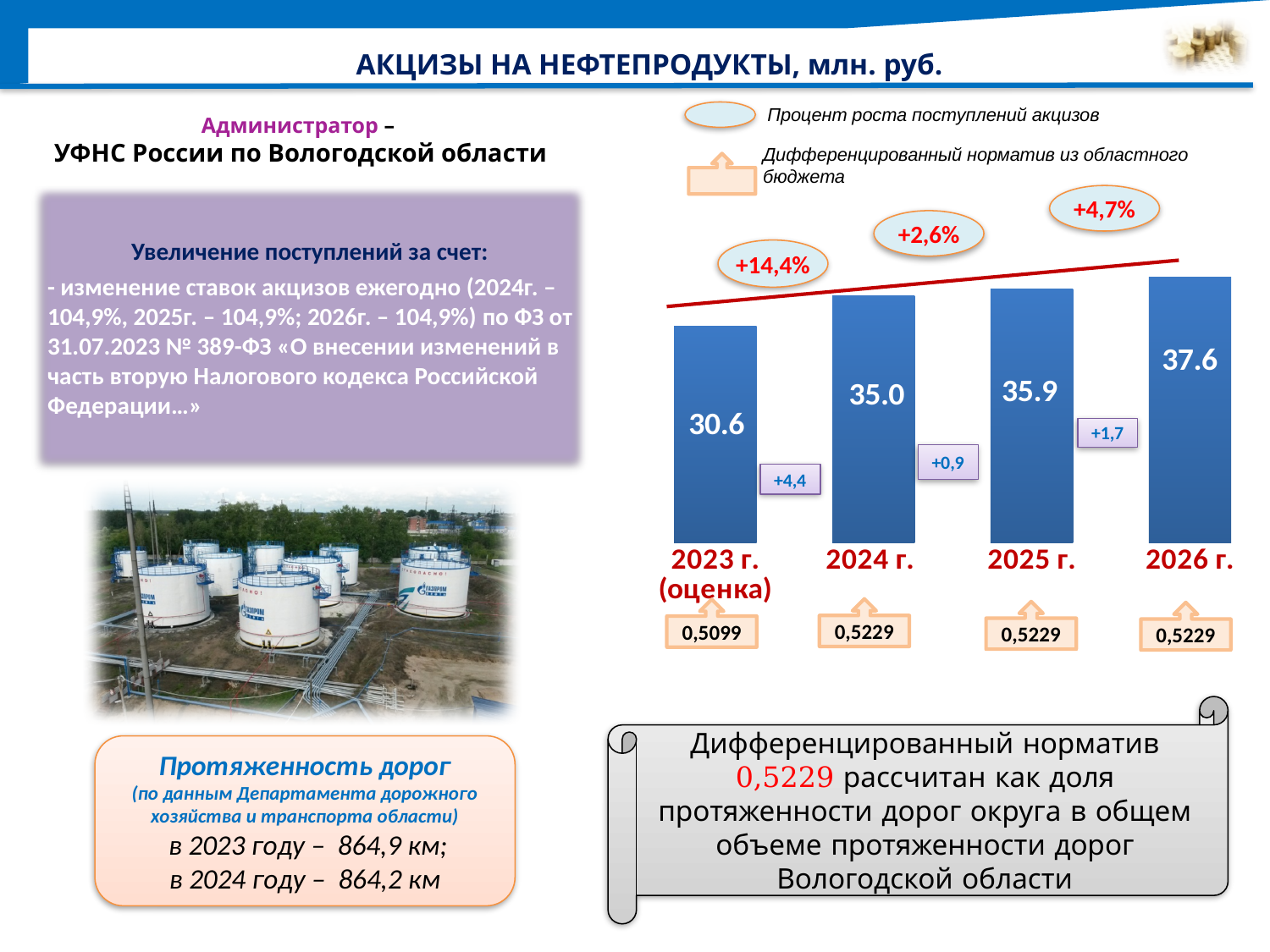
Do the bar values rise or fall from 2023 to 2026? rise Which year has the highest bar? 2026 г. What is the difference between the values for 2026 г. and 2023 г. (оценка)? 7.0 What is the value of the bar for 2026 г.? 37.6 What is the value of the bar for 2025 г.? 35.9 What is the value of the bar for 2023 г. (оценка)? 30.6 Which year has the lowest bar? 2023 г. (оценка) What kind of chart is shown on the slide? bar chart How many bars are shown in the chart? 4 What is the difference between the values for 2024 г. and 2023 г. (оценка)? 4.4 Which is larger, the value for 2024 г. or the value for 2025 г.? 2025 г.